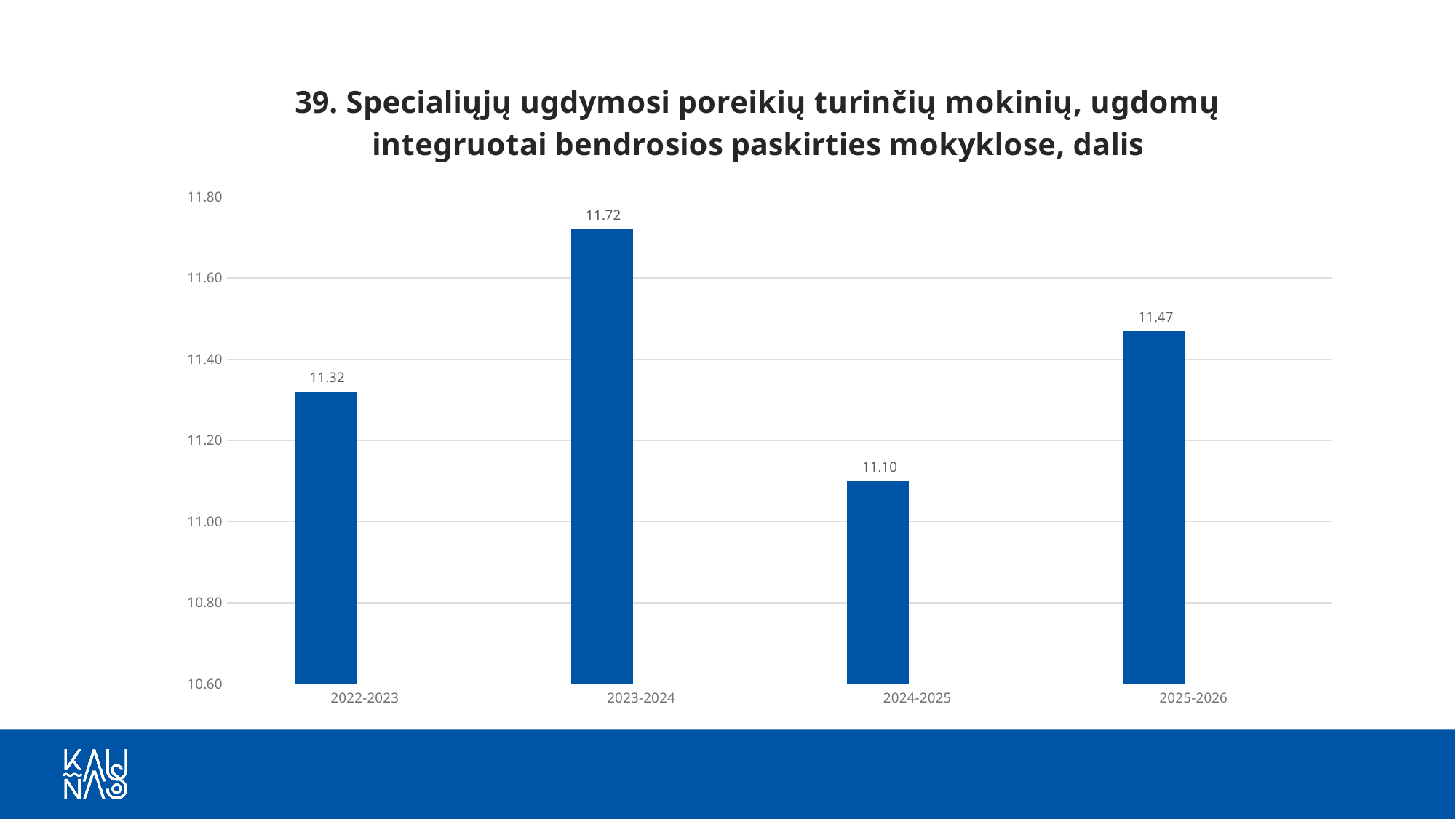
What is the difference between the values for 2023-2024 and 2024-2025? 0.62 Which school year has the highest value? 2023-2024 What is the value for 2025-2026? 11.47 Which is larger, the value for 2022-2023 or the value for 2025-2026? 2025-2026 How many school years are shown on the chart? 4 Does the value rise or fall from 2024-2025 to 2025-2026? rise Is the value for 2024-2025 greater or less than 11.20? less What is the value for 2023-2024? 11.72 What is the value for 2022-2023? 11.32 What is the value for 2024-2025? 11.10 What kind of chart is shown on the slide? bar chart Which school year has the lowest value? 2024-2025